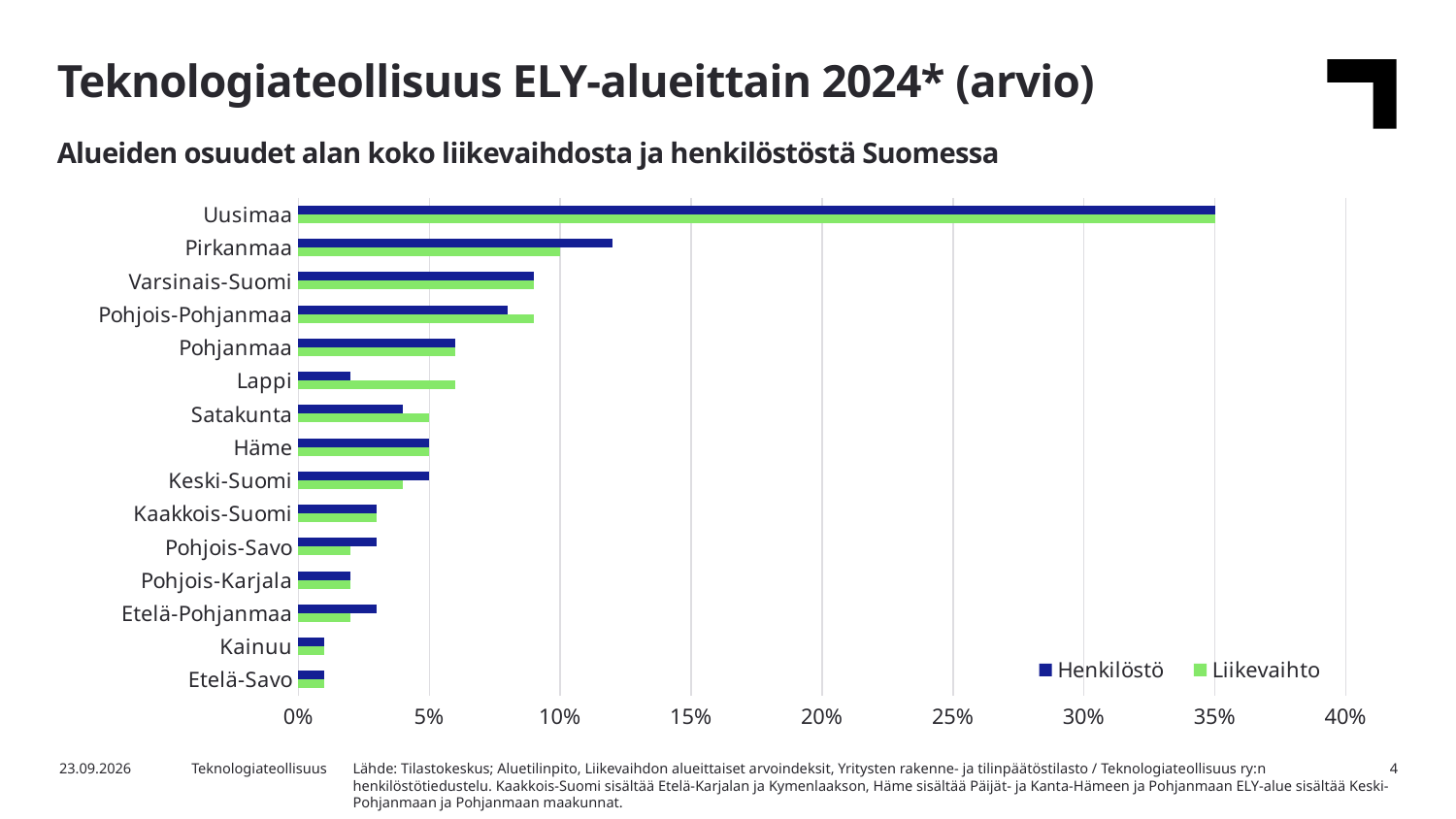
Is the Liikevaihto value for Pohjois-Pohjanmaa greater or less than 5%? greater Which region has the highest Henkilöstö share? Uusimaa Is the Liikevaihto value for Uusimaa greater or less than 30%? greater How many regions (categories) are plotted on the chart? 15 Is the Henkilöstö value for Lappi greater or less than 5%? less For Lappi, which is larger: the Henkilöstö share or the Liikevaihto share? Liikevaihto What colour represents the Liikevaihto series in the legend? Green For Pirkanmaa, which is larger: the Henkilöstö share or the Liikevaihto share? Henkilöstö What kind of chart is shown on the slide? Bar chart How many series does the legend list? 2 Which region has the highest Liikevaihto share? Uusimaa